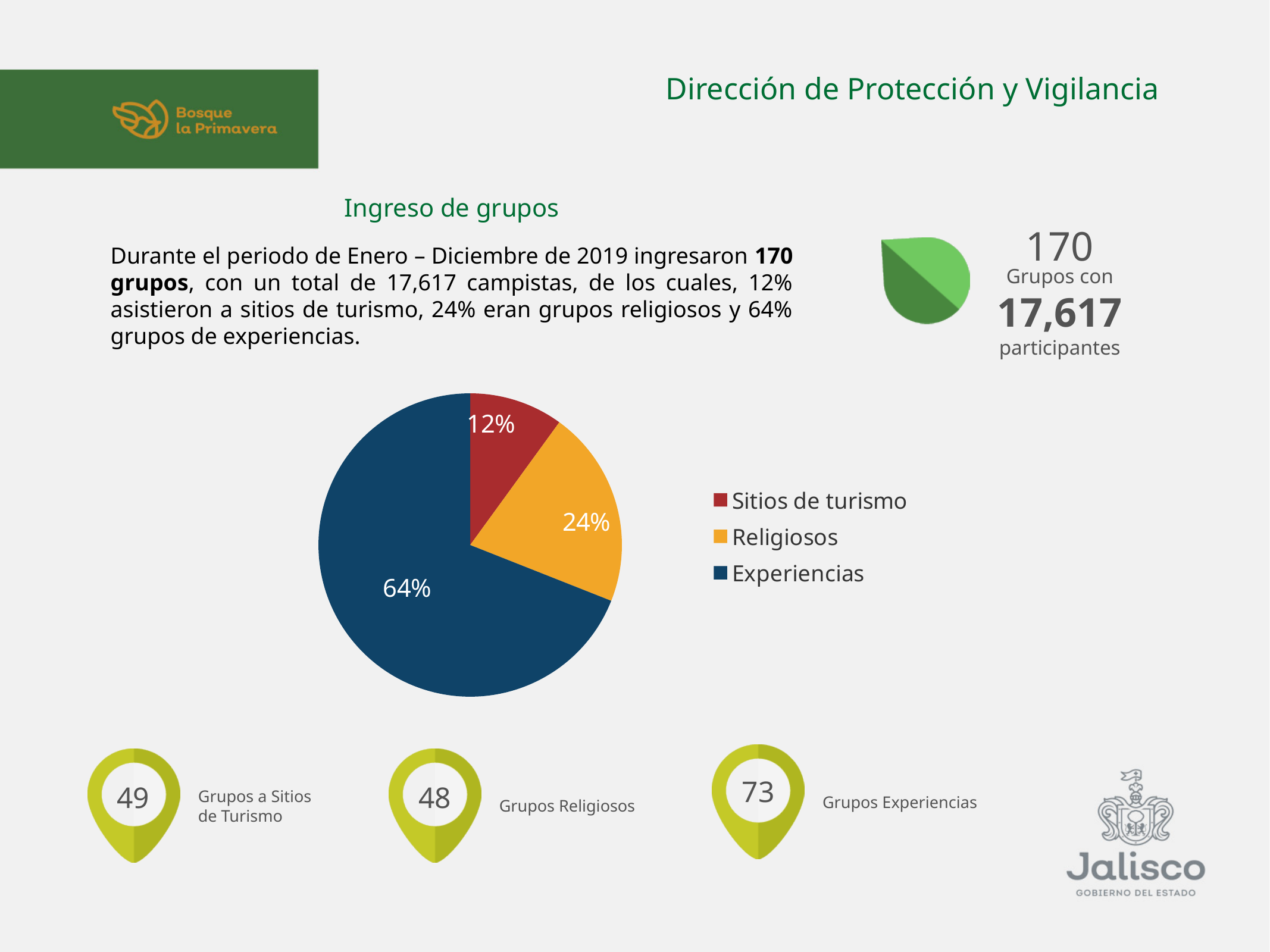
What share of the pie does Sitios de turismo represent? 12% What kind of chart is shown on the slide? Pie chart What colour is the Experiencias slice in the pie chart? Dark blue What share of the pie does Experiencias represent? 64% What is the difference in percentage points between the Experiencias slice and the Religiosos slice? 40% Which category has the smallest slice of the pie? Sitios de turismo Which category has the largest slice of the pie? Experiencias How many categories does the pie chart show? 3 What share of the pie does Religiosos represent? 24% Which legend entry is shown in orange? Religiosos Which slice is larger, Religiosos or Sitios de turismo? Religiosos What is the difference in percentage points between the Religiosos slice and the Sitios de turismo slice? 12%